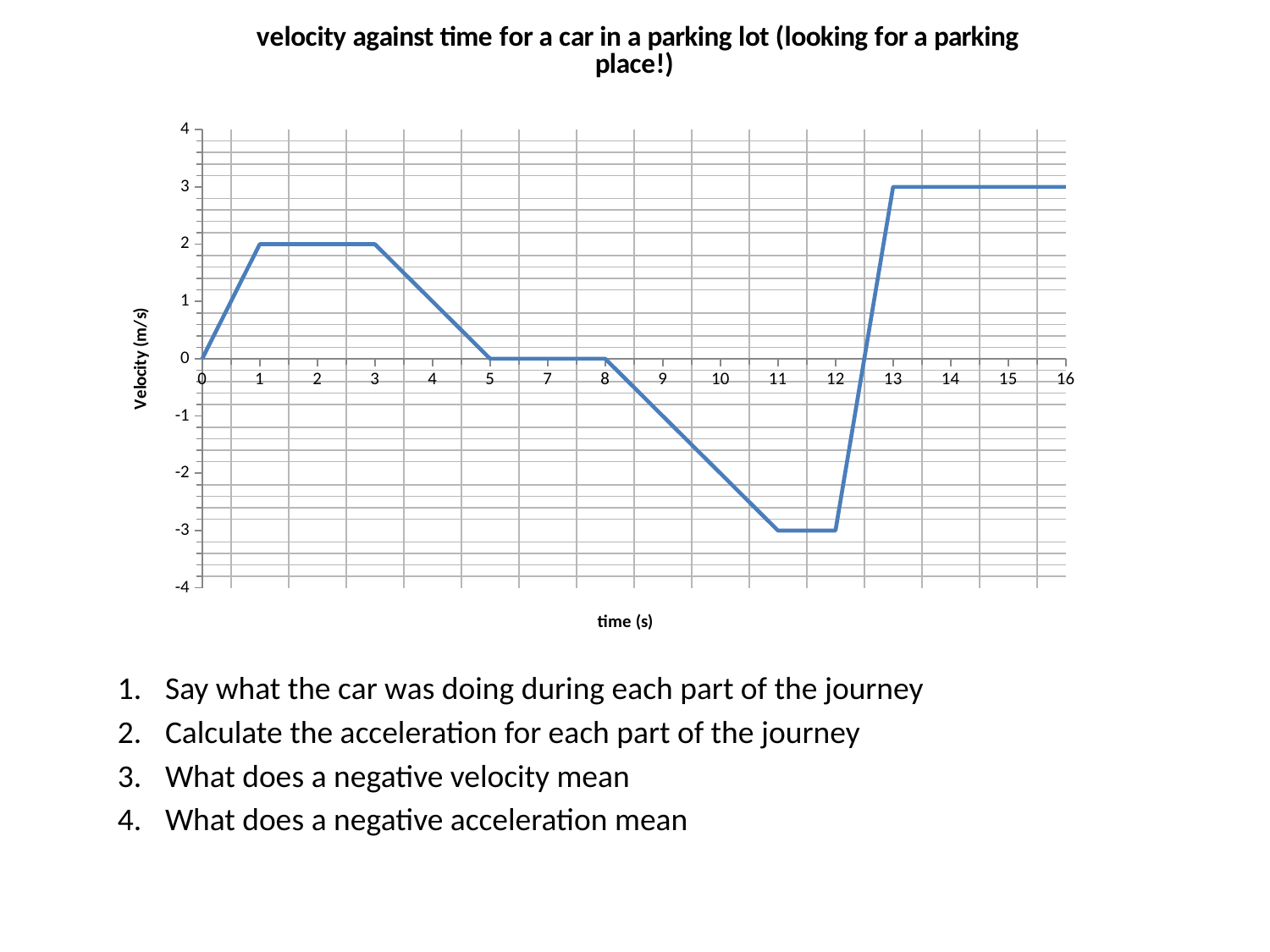
Is the velocity at time 12 s greater or less than 0? less What is the highest velocity reached on the chart? 3 What type of chart is shown on the slide? line chart What is the velocity at time 16 s? 3 What is the velocity at time 1 s? 2 What is the velocity at time 3 s? 2 What is the velocity at time 11 s? -3 What is the label of the vertical axis? Velocity (m/s) What is the lowest velocity reached on the chart? -3 What is the velocity at time 5 s? 0 What is the velocity at time 13 s? 3 Does the velocity rise or fall between time 3 s and time 5 s? fall